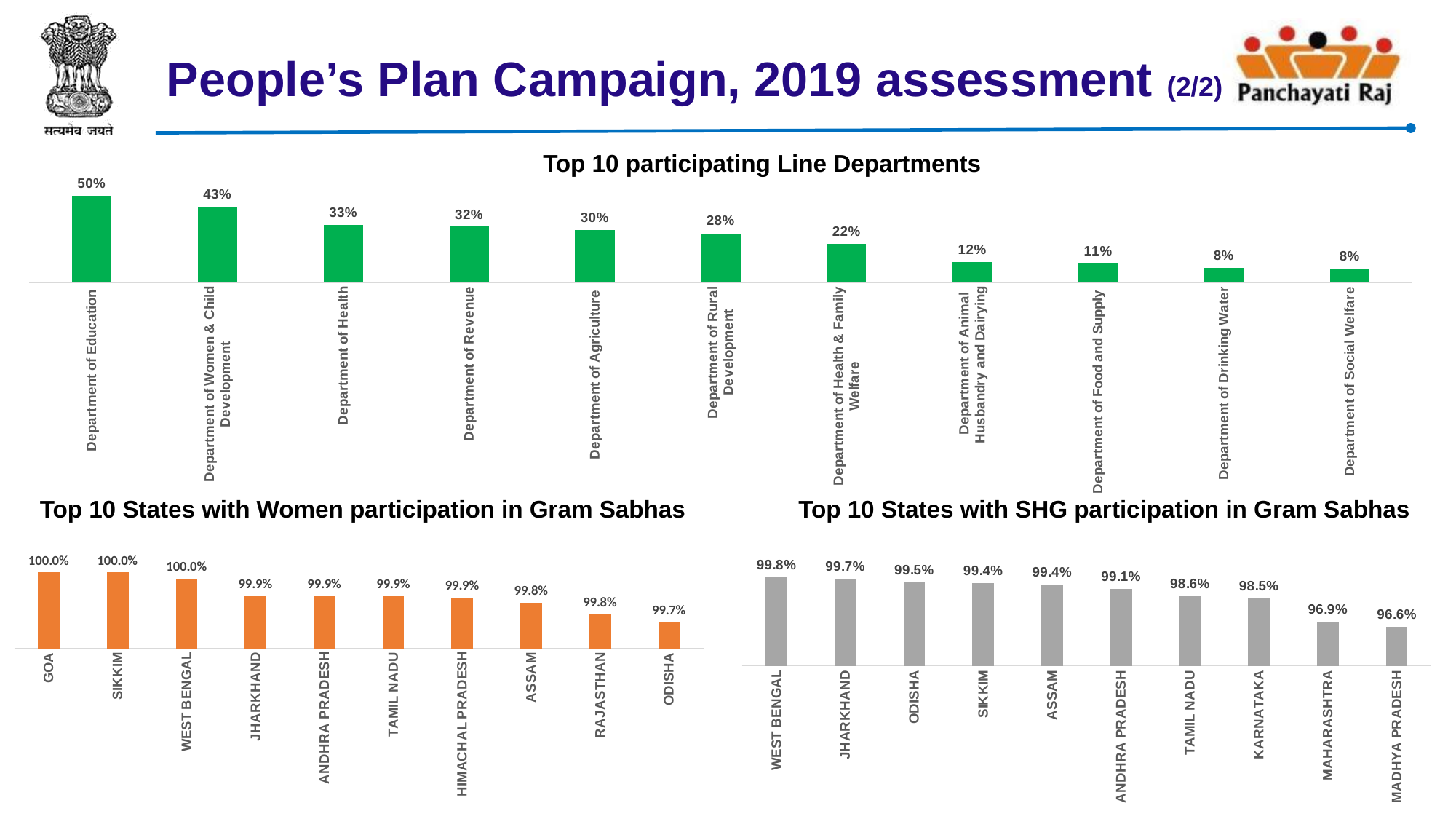
In the 'Top 10 States with SHG participation in Gram Sabhas' chart, what is the difference between West Bengal and Madhya Pradesh? 3.2% In the 'Top 10 participating Line Departments' chart, how many departments are shown? 11 In the 'Top 10 States with SHG participation in Gram Sabhas' chart, which state has the highest value? West Bengal What type of chart is the 'Top 10 States with SHG participation in Gram Sabhas' chart? Bar chart In the 'Top 10 participating Line Departments' chart, which department has the highest value? Department of Education In the 'Top 10 participating Line Departments' chart, what is the difference between Department of Education and Department of Women & Child Development? 7% In the 'Top 10 participating Line Departments' chart, what is the value for Department of Health & Family Welfare? 22% In the 'Top 10 States with Women participation in Gram Sabhas' chart, what is the value for Assam? 99.8% In the 'Top 10 States with SHG participation in Gram Sabhas' chart, what is the value for Karnataka? 98.5% In the 'Top 10 participating Line Departments' chart, what is the value for Department of Education? 50% In the 'Top 10 participating Line Departments' chart, which is larger: Department of Revenue or Department of Agriculture? Department of Revenue In the 'Top 10 States with Women participation in Gram Sabhas' chart, which state has the lowest value? Odisha